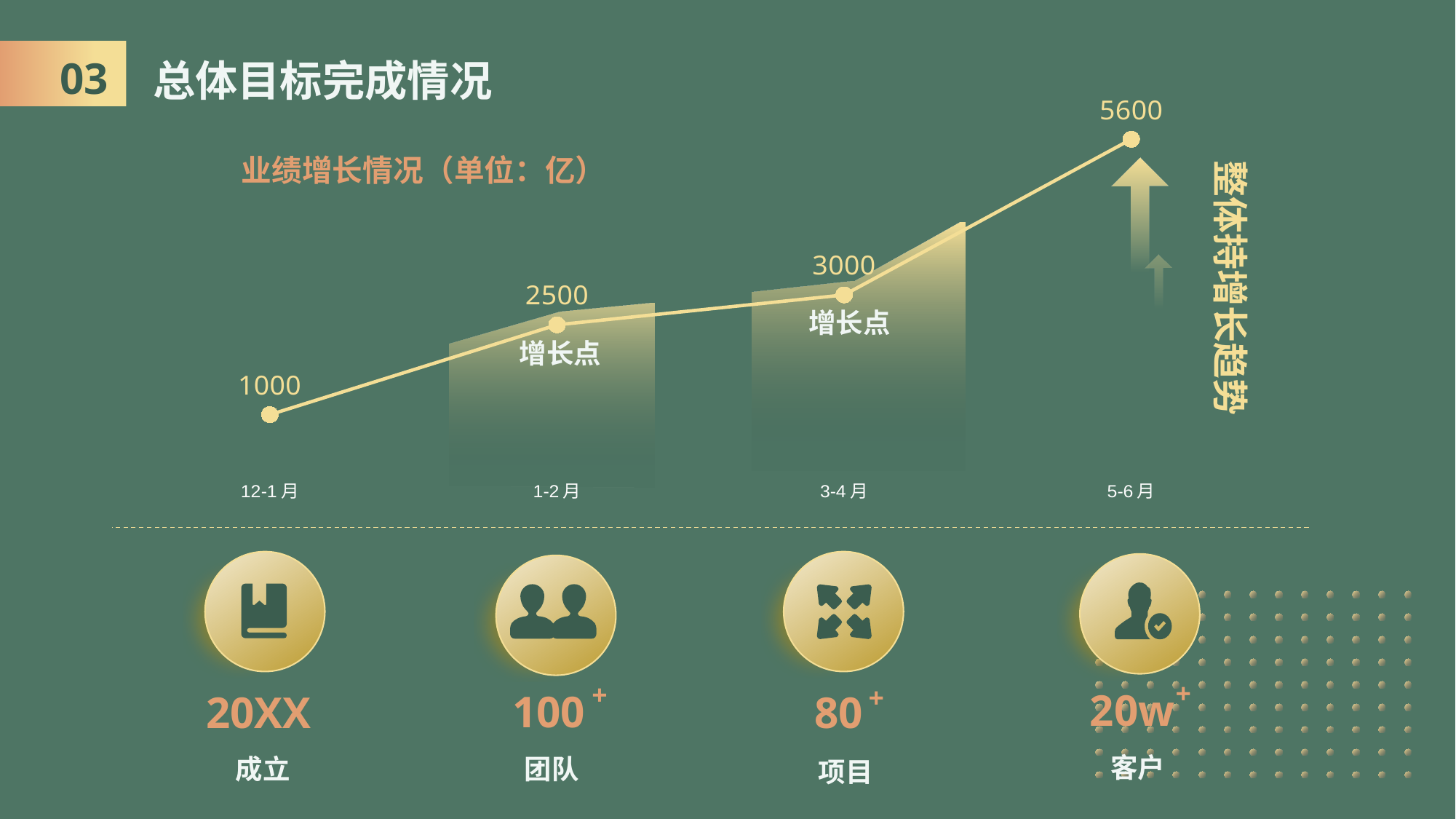
Which is larger in the 业绩增长情况 chart, the value for 1-2月 or 3-4月? 3-4月 What is the value for 12-1月 in the 业绩增长情况 chart? 1000 How many data points are plotted in the 业绩增长情况 chart? 4 Which period has the lowest value in the 业绩增长情况 chart? 12-1月 What is the value for 1-2月 in the 业绩增长情况 chart? 2500 What is the value for 3-4月 in the 业绩增长情况 chart? 3000 Do the values in the 业绩增长情况 chart rise or fall from 12-1月 to 5-6月? rise What is the value for 5-6月 in the 业绩增长情况 chart? 5600 What is the difference between the values for 1-2月 and 12-1月 in the 业绩增长情况 chart? 1500 What kind of chart is the 业绩增长情况 chart? line chart What is the difference between the values for 5-6月 and 3-4月 in the 业绩增长情况 chart? 2600 Which period has the highest value in the 业绩增长情况 chart? 5-6月